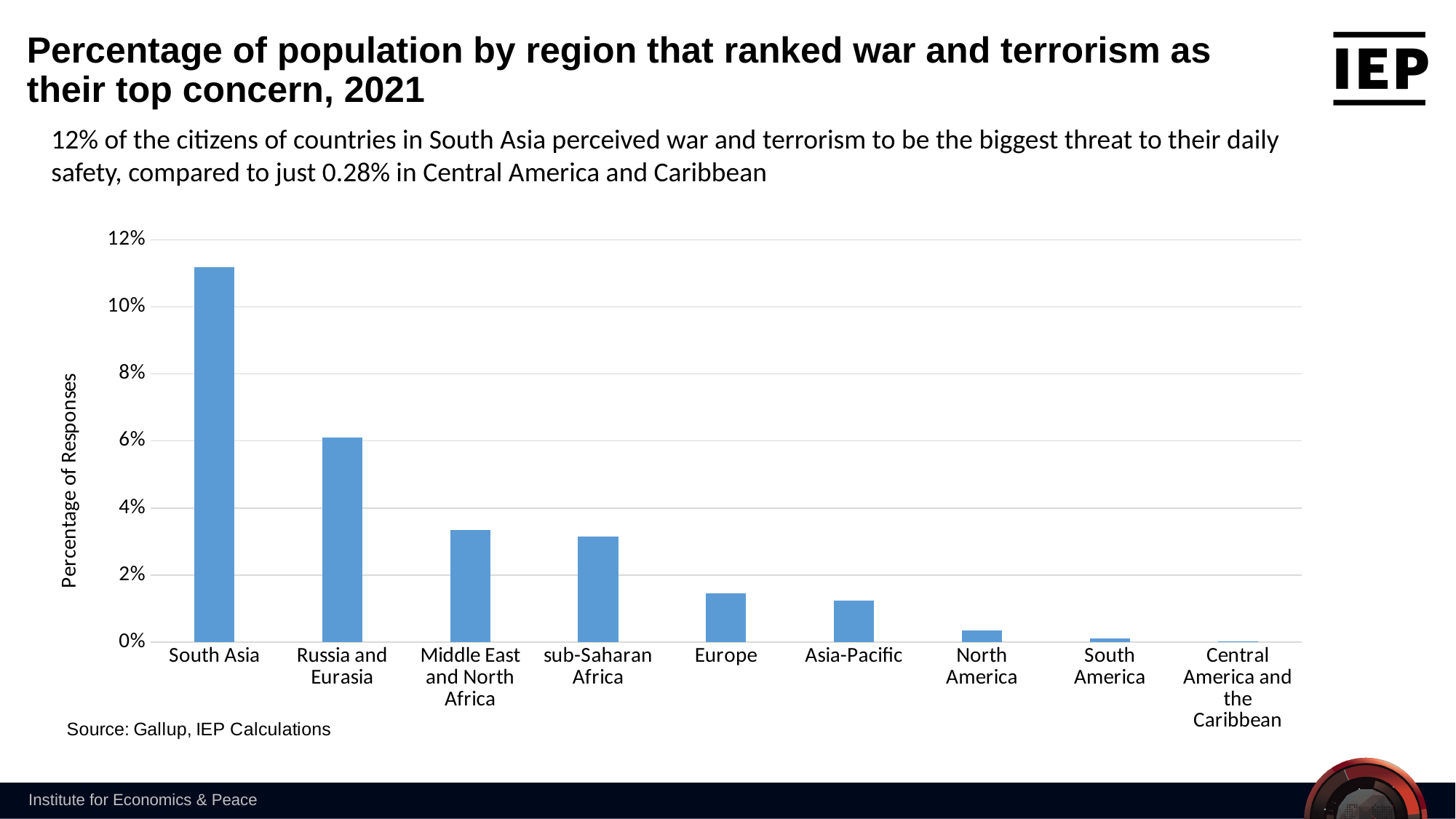
Which region has the highest percentage of population ranking war and terrorism as their top concern? South Asia What is the label on the y axis of the chart? Percentage of Responses Which region has the lowest percentage of population ranking war and terrorism as their top concern? Central America and the Caribbean Is the value for Middle East and North Africa greater or less than 2%? greater How many regions are shown on the x axis of the chart? 9 Is the value for Russia and Eurasia greater or less than 4%? greater Which region has a higher value: Russia and Eurasia or Europe? Russia and Eurasia Is the value for South Asia greater or less than 10%? greater Do the bar values rise or fall moving from left to right along the x axis? Fall What kind of chart is shown on the slide? Bar chart Which region has a higher value: Asia-Pacific or North America? Asia-Pacific